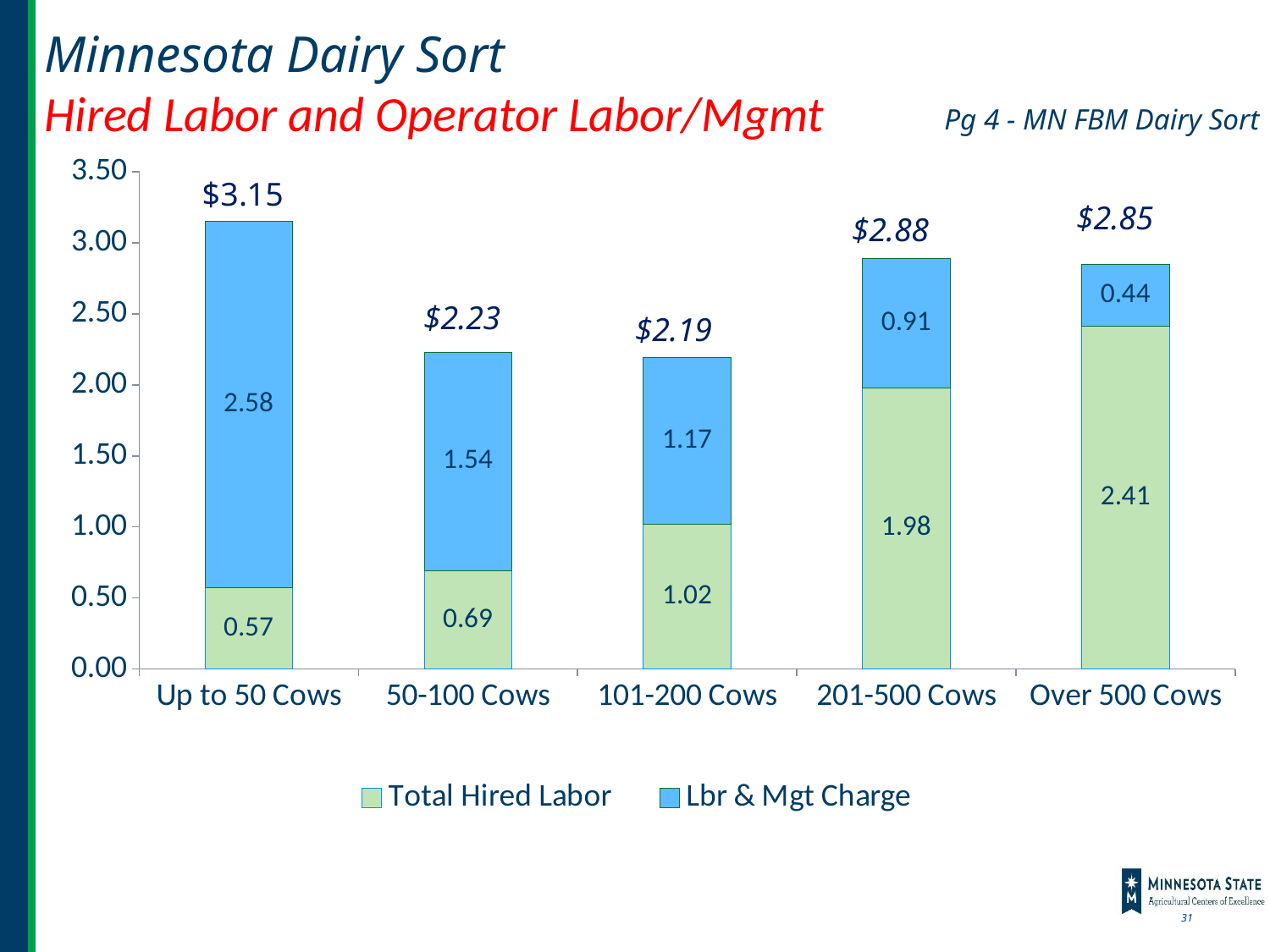
How many series does the legend list? 2 Which is larger: the Total Hired Labor value for 201-500 Cows or the Lbr & Mgt Charge value for 50-100 Cows? Total Hired Labor for 201-500 Cows What is the total of the stacked bar for the 201-500 Cows category? $2.88 What kind of chart is shown on the slide? Stacked bar chart What is the Lbr & Mgt Charge value for the Up to 50 Cows category? 2.58 How many categories are shown on the x axis? 5 Which category has the highest stacked bar total? Up to 50 Cows Which category has the lowest Lbr & Mgt Charge value? Over 500 Cows Which category has the lowest stacked bar total? 101-200 Cows What is the Total Hired Labor value for the 101-200 Cows category? 1.02 Does the Total Hired Labor value rise or fall from Up to 50 Cows to Over 500 Cows? Rise What is the difference between the Total Hired Labor values for Over 500 Cows and Up to 50 Cows? 1.84